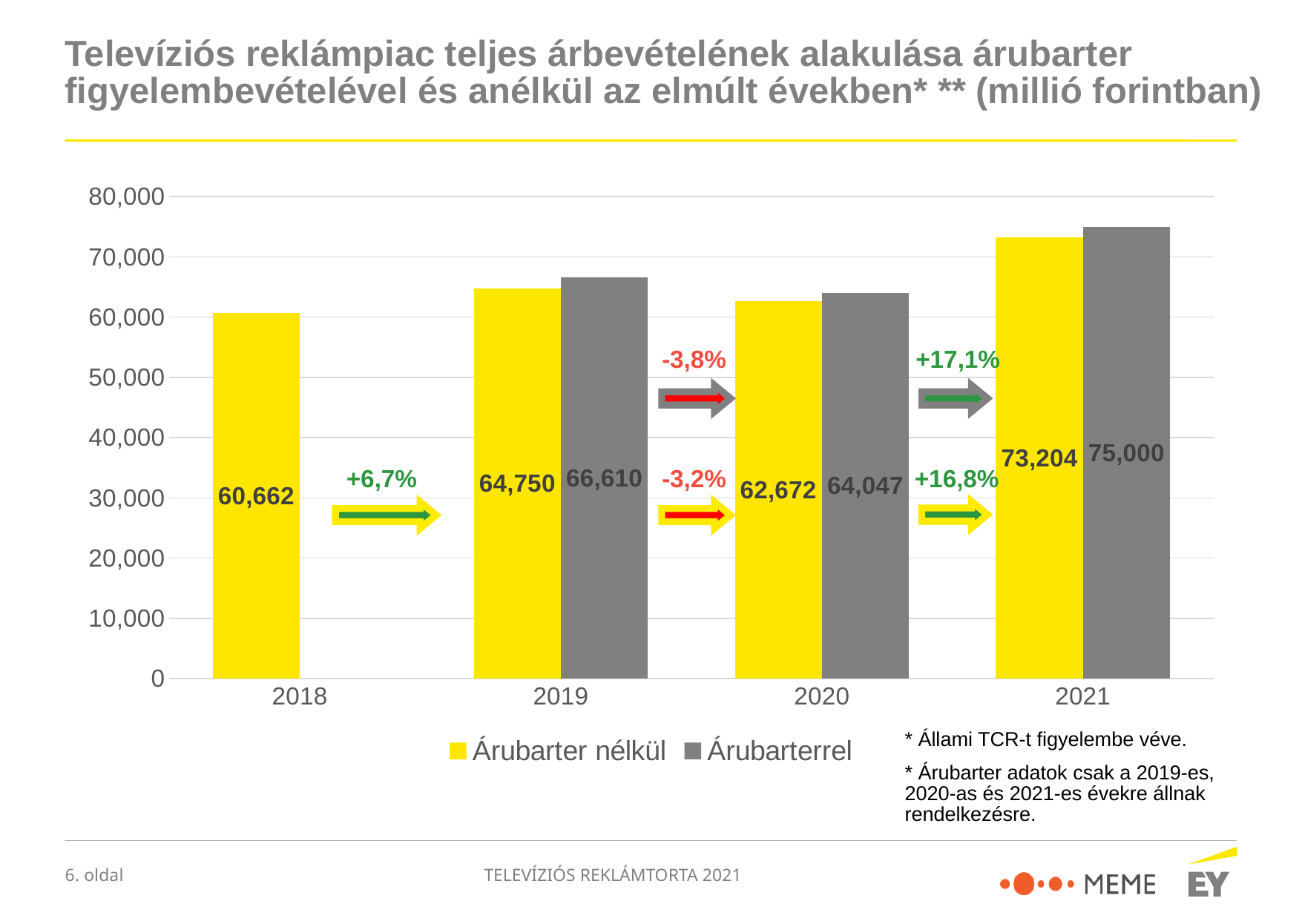
What kind of chart is shown on the slide? Bar chart Which is larger in 2020: "Árubarter nélkül" or "Árubarterrel"? Árubarterrel Is the value for "Árubarter nélkül" in 2021 greater or less than 70,000? greater What is the value for "Árubarter nélkül" in 2018? 60,662 Which year has the highest value for "Árubarter nélkül"? 2021 What is the difference between "Árubarterrel" and "Árubarter nélkül" in 2019? 1,860 What is the value for "Árubarterrel" in 2021? 75,000 Which year has the lowest value for "Árubarterrel"? 2020 What percentage change is shown for "Árubarter nélkül" between 2020 and 2021? +16,8% What is the value for "Árubarter nélkül" in 2020? 62,672 How many series does the legend list? 2 How many years are shown on the x axis? 4